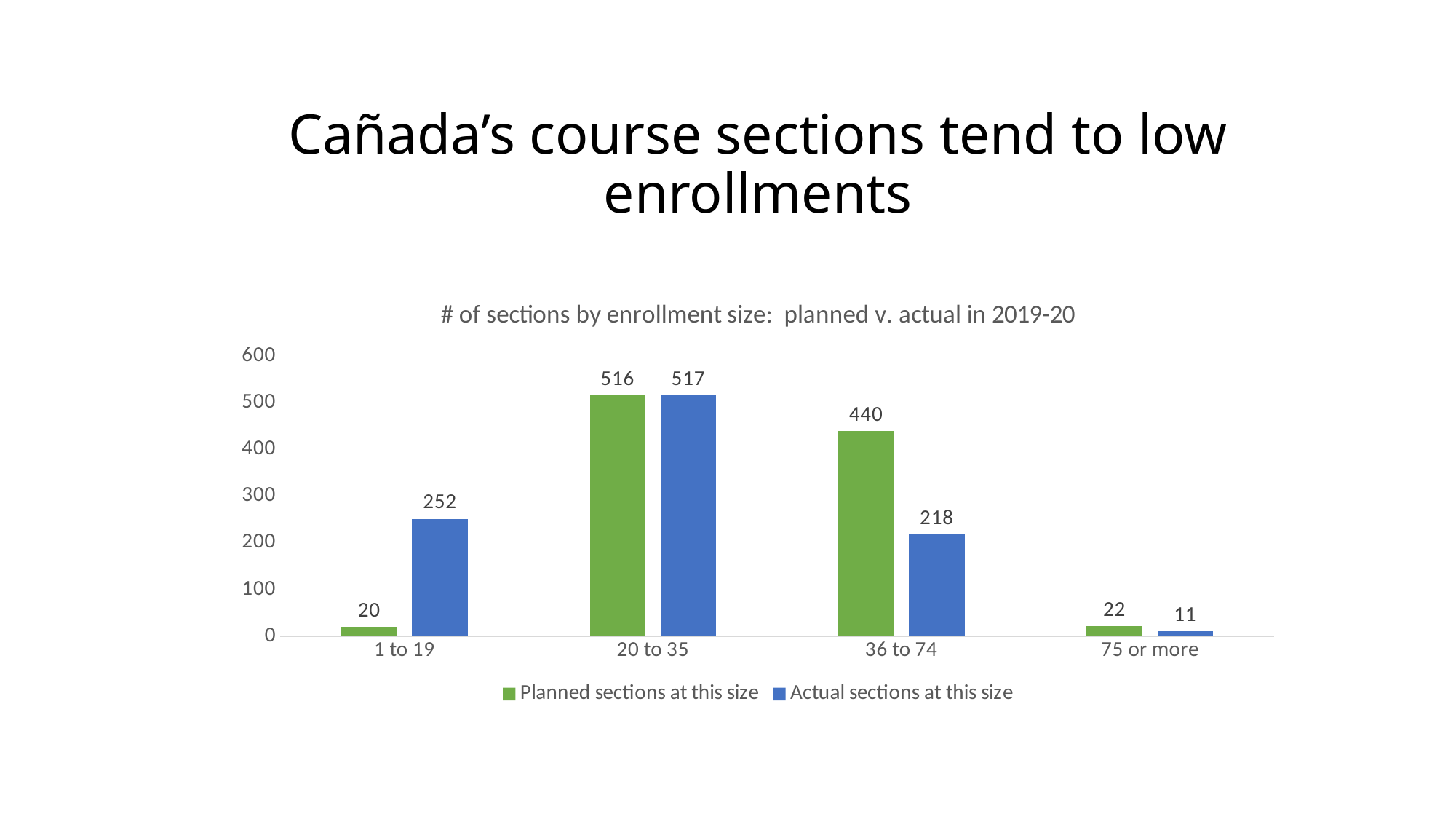
How many series does the legend list? 2 What kind of chart is shown on the slide? Bar chart Which is larger at the 75 or more enrollment size: planned sections or actual sections? Planned sections at this size What is the number of actual sections at the 36 to 74 enrollment size? 218 What is the difference between planned and actual sections at the 36 to 74 enrollment size? 222 What is the number of planned sections at the 1 to 19 enrollment size? 20 What is the difference between actual and planned sections at the 1 to 19 enrollment size? 232 Which enrollment size category has the lowest number of planned sections? 1 to 19 What is the title of the chart? # of sections by enrollment size: planned v. actual in 2019-20 Which enrollment size category has the highest number of actual sections? 20 to 35 What is the number of actual sections at the 75 or more enrollment size? 11 How many enrollment size categories are shown on the x axis? 4